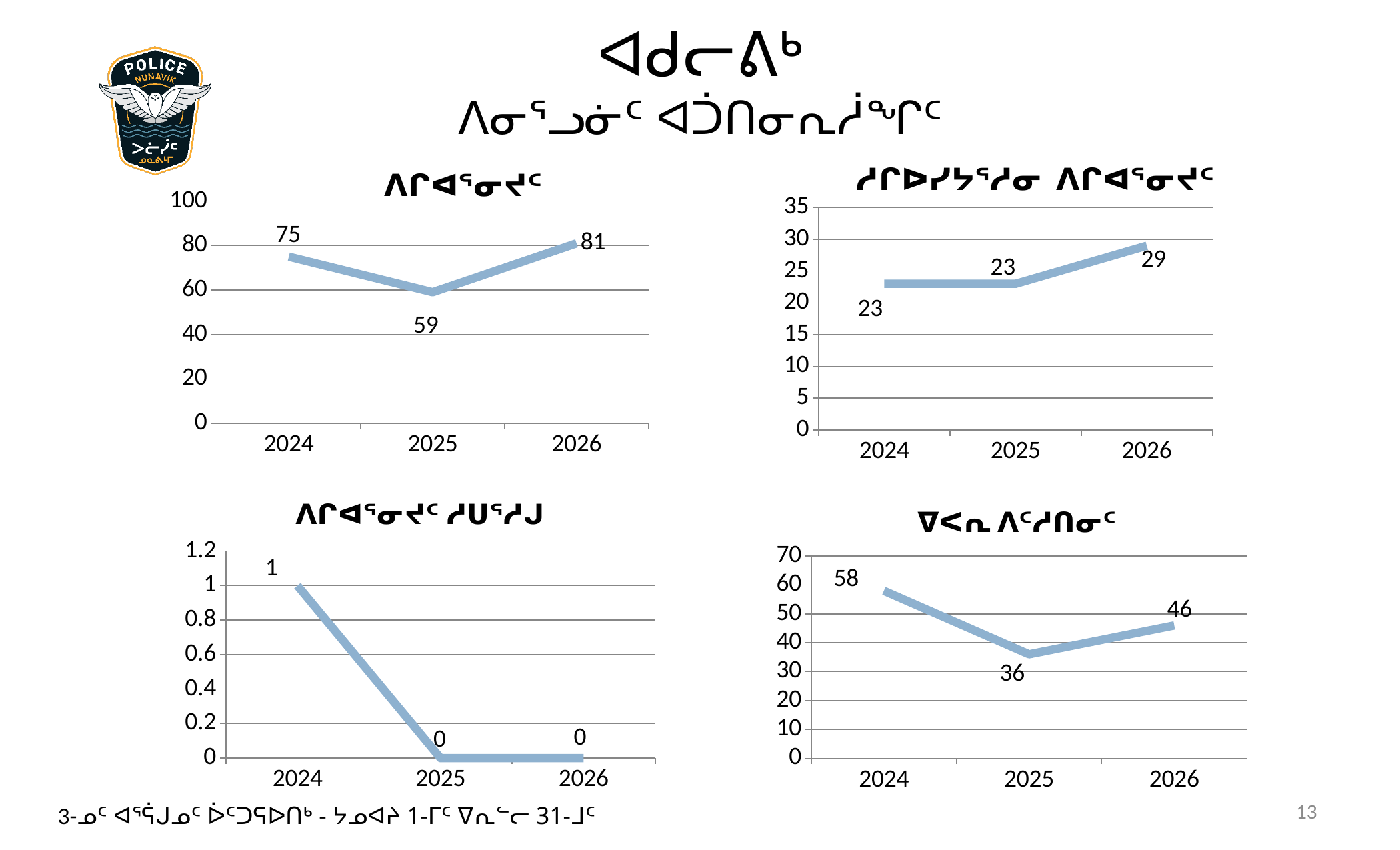
In the top-right chart, what is the difference between the 2026 and 2024 values? 6 In the bottom-right chart, which year has the lowest value? 2025 What kind of chart is the bottom-right chart? line chart In the top-left chart, what is the difference between the 2026 and 2025 values? 22 In the top-left chart, which year has the highest value? 2026 In the bottom-right chart, what is the value for 2025? 36 In the bottom-left chart, do the values rise or fall from 2024 to 2026? fall In the top-right chart, what is the value for 2026? 29 In the top-left chart, what is the value for 2025? 59 In the bottom-left chart, what is the value for 2024? 1 In the top-right chart, is the value for 2026 greater or less than 25? greater In the bottom-right chart, which is larger, the value for 2024 or the value for 2026? 2024